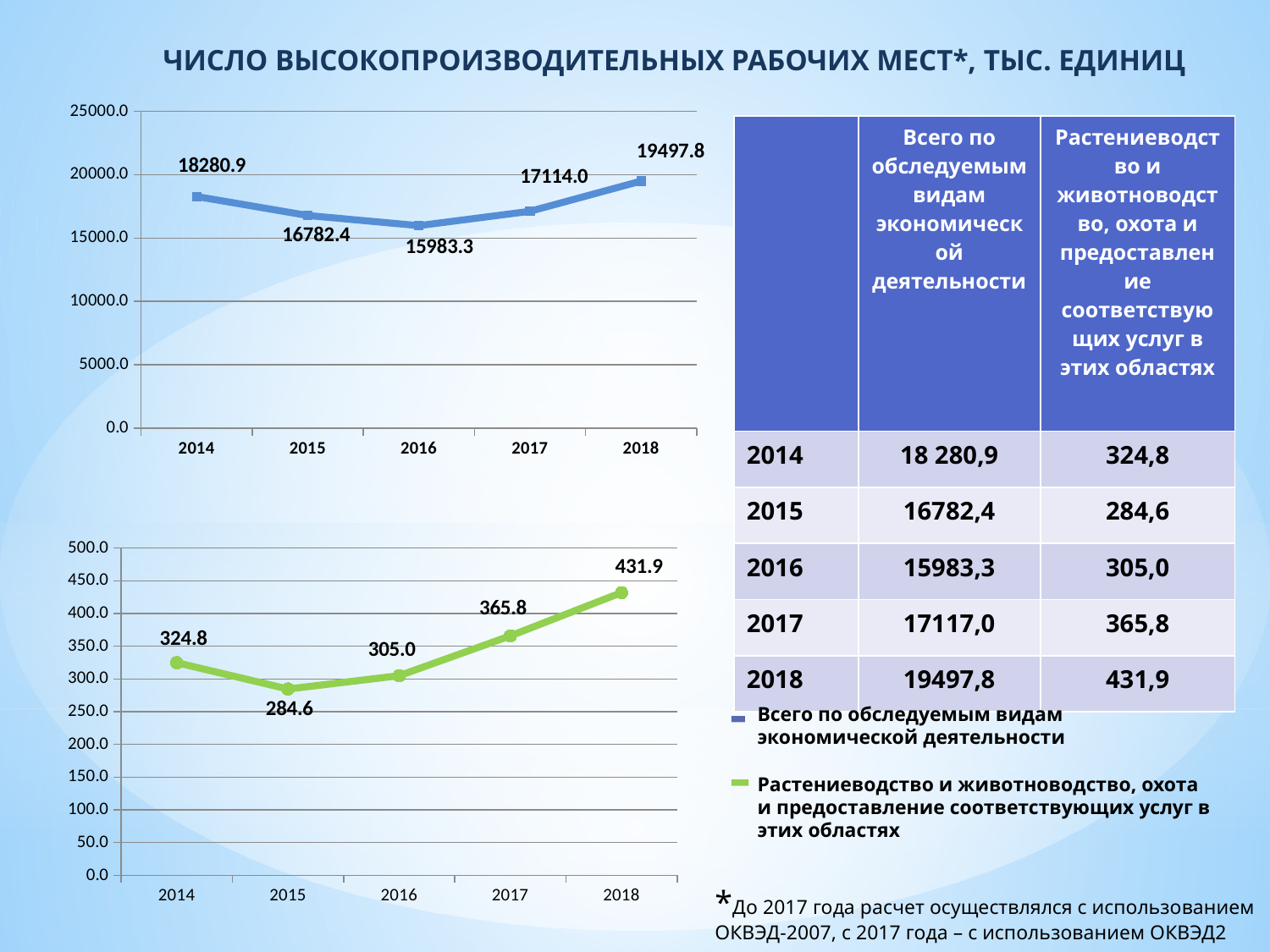
On the top chart, what is the value for 2018? 19497.8 On the top chart, which year has the lowest value? 2016 On the bottom chart, what is the difference between the values for 2018 and 2014? 107.1 What type of chart is the top chart? line chart On the bottom chart, which year has the highest value? 2018 On the bottom chart, what is the value for 2016? 305.0 On the top chart, what is the value for 2014? 18280.9 How many years are plotted on the bottom chart? 5 On the bottom chart, what is the value for 2017? 365.8 On the bottom chart, which year has the lowest value? 2015 On the top chart, which is larger: the value for 2015 or the value for 2016? 2015 On the top chart, is the value for 2018 greater or less than 15000.0? greater